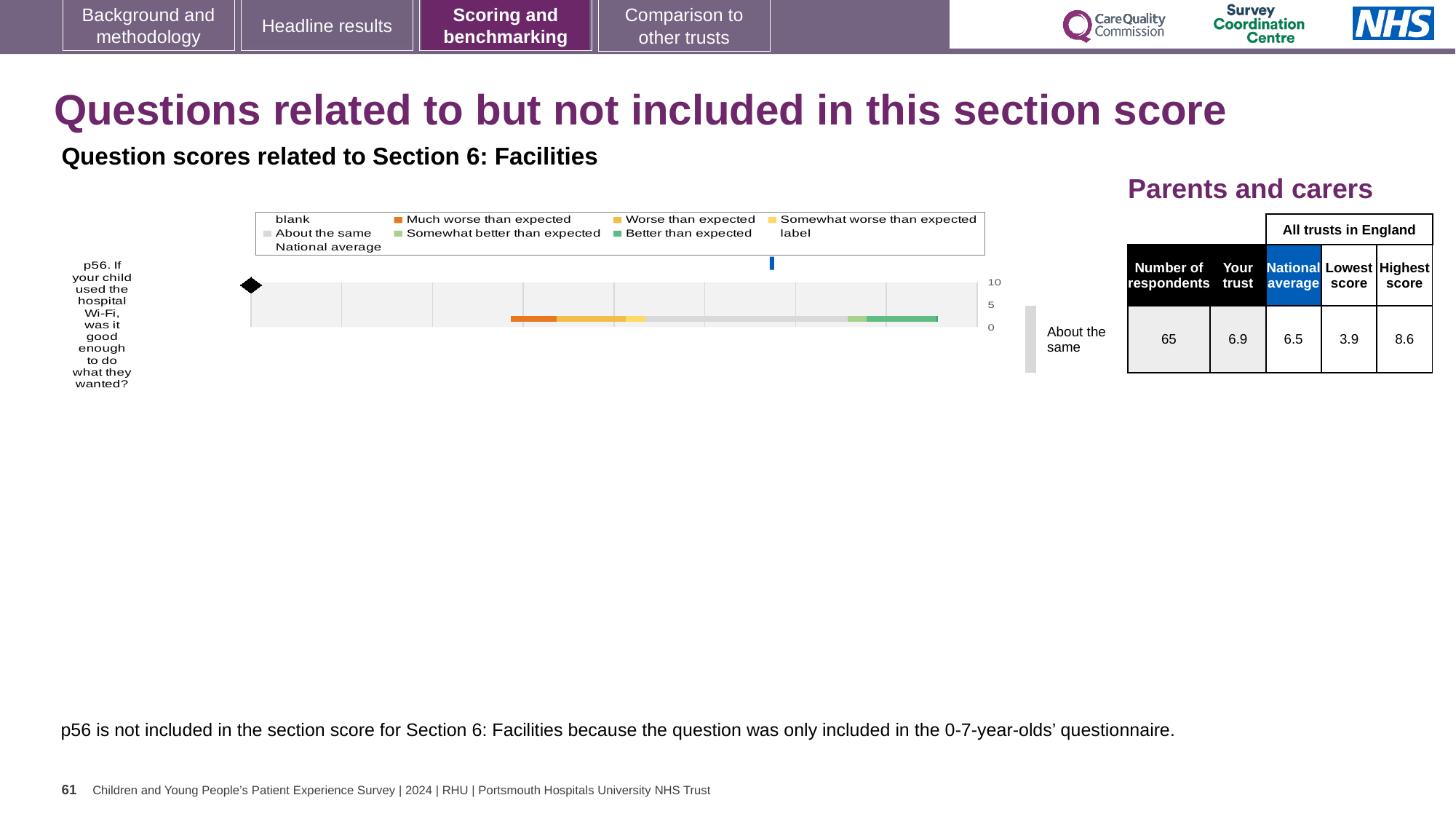
What is the highest score among all trusts in England for p56? 8.6 What is the national average score for p56? 6.5 Which benchmark category is the trust's p56 result labelled as? About the same How many respondents answered p56? 65 Which question number is plotted in the chart? p56 What is the difference between the highest and lowest scores for p56? 4.7 Is the 'Your trust' score for p56 higher or lower than the national average? higher What is the difference between the 'Your trust' score and the national average for p56? 0.4 What is the lowest score among all trusts in England for p56? 3.9 What is the 'Your trust' score for p56? 6.9 What kind of chart is used to show the p56 question score? bar chart How many questions are plotted in the chart? 1